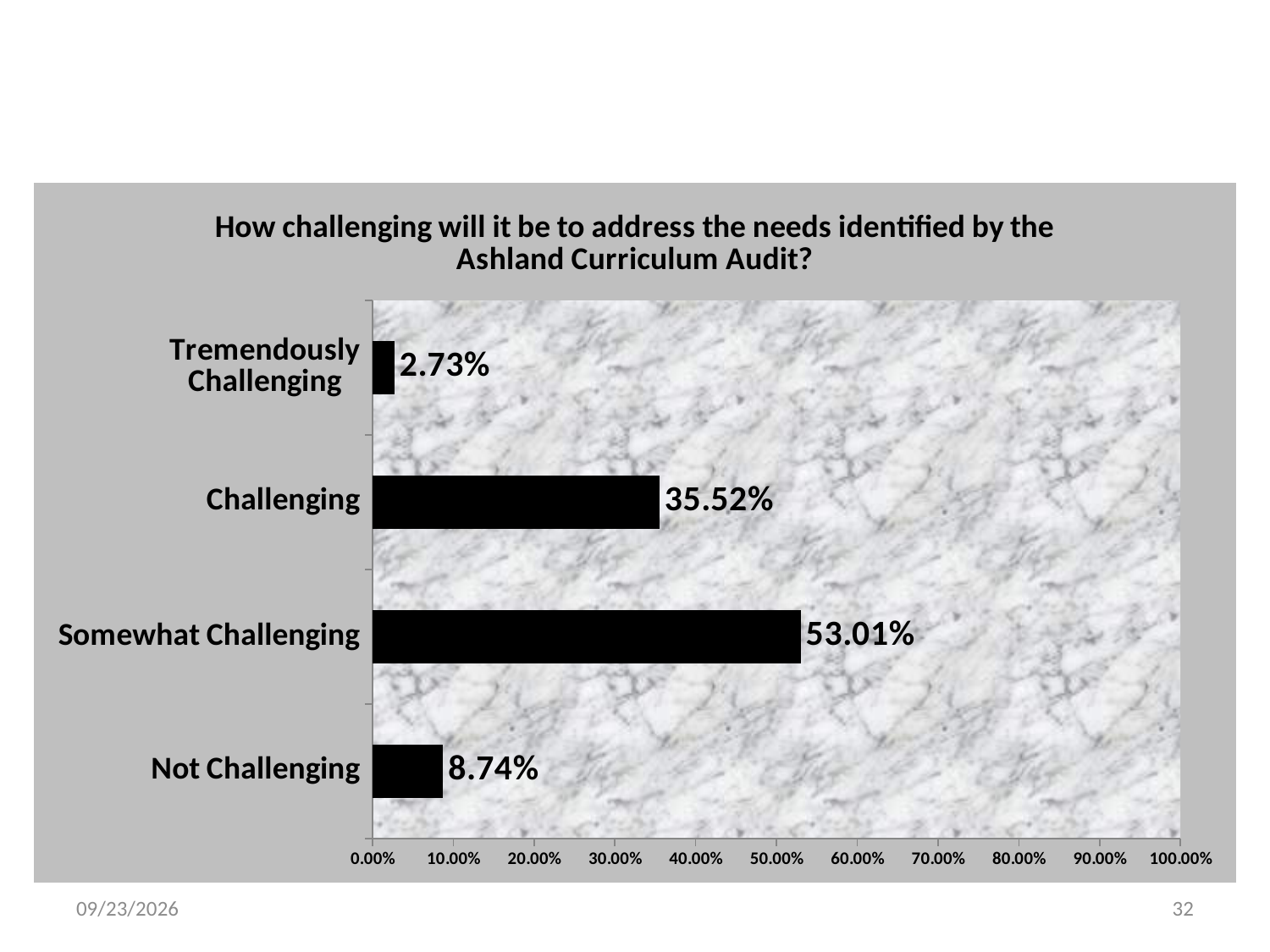
How many categories are shown in the chart? 4 What is the value for Not Challenging? 8.74% Is the value for Somewhat Challenging greater or less than 50.00%? greater What kind of chart is shown on the slide? Bar chart Which category has the highest value? Somewhat Challenging Which category has the lowest value? Tremendously Challenging What is the value for Challenging? 35.52% Which is larger, the value for Challenging or the value for Not Challenging? Challenging What is the difference between the values for Not Challenging and Tremendously Challenging? 6.01% What is the value for Tremendously Challenging? 2.73% What percentage of respondents said it would be Somewhat Challenging? 53.01% What is the difference between the values for Somewhat Challenging and Challenging? 17.49%